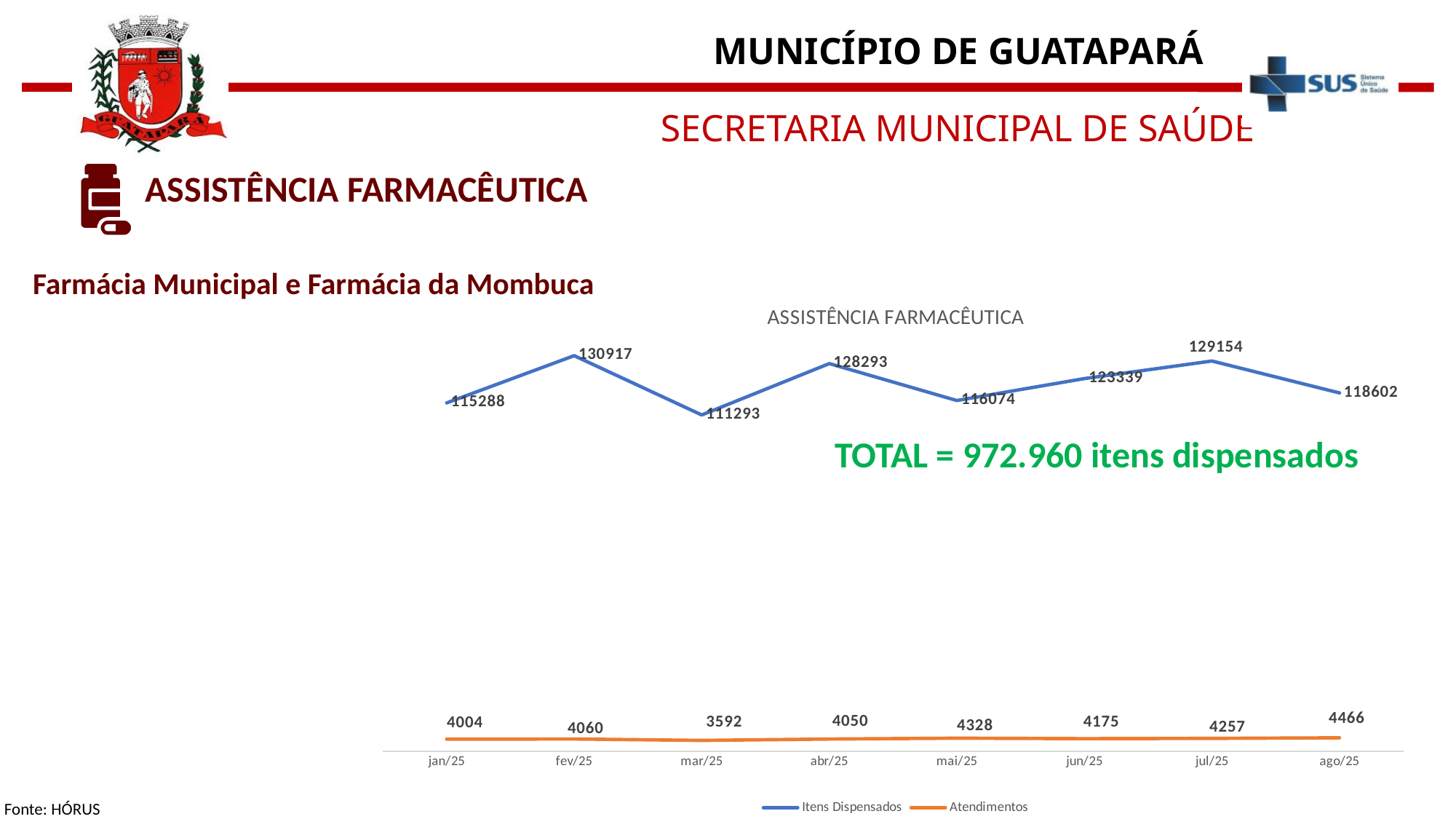
In which month is Atendimentos highest? ago/25 In which month is Itens Dispensados highest? fev/25 What is the difference between Itens Dispensados in fev/25 and mar/25? 19624 Which month has more Itens Dispensados, abr/25 or mai/25? abr/25 How many series does the legend list? 2 What kind of chart is shown? line chart What is the value of Itens Dispensados for fev/25? 130917 In which month is Atendimentos lowest? mar/25 How many months are plotted on the x axis? 8 In which month is Itens Dispensados lowest? mar/25 What is the difference between Atendimentos in ago/25 and jan/25? 462 What is the value of Atendimentos for mai/25? 4328